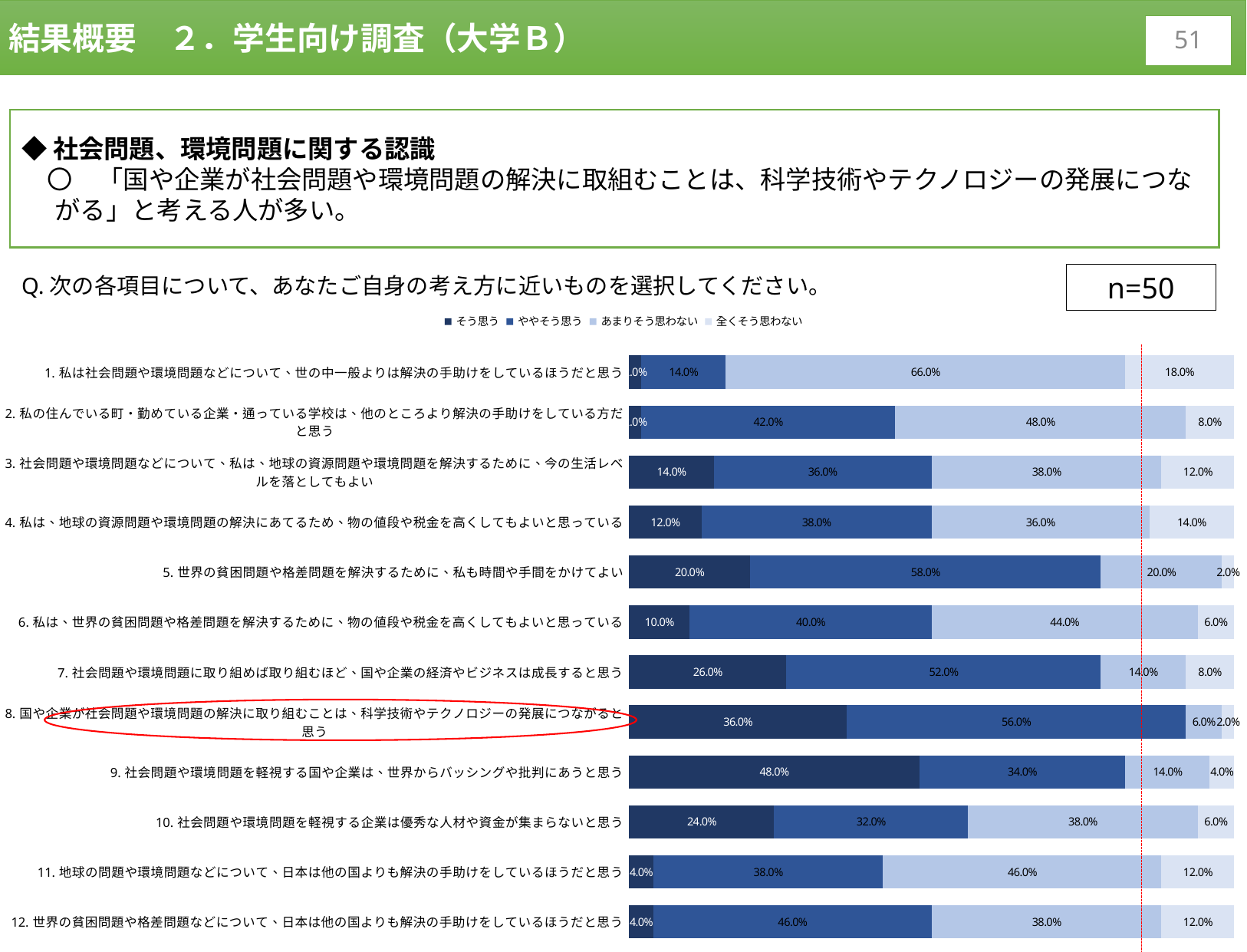
What is the sample size (n) shown on the slide? n=50 What is the combined total of そう思う and ややそう思う for item 8? 92.0% What is the あまりそう思わない value for item 1 (私は社会問題や環境問題などについて、世の中一般よりは解決の手助けをしているほうだと思う)? 66.0% How many series does the legend list? 4 Which item has the lowest 全くそう思わない value? 5 and 8 (both 2.0%) What is the そう思う value for item 8 (国や企業が社会問題や環境問題の解決に取り組むことは、科学技術やテクノロジーの発展につながると思う)? 36.0% What is the difference between the そう思う values for item 9 and item 8? 12.0% How many items (categories) are plotted in the chart? 12 What is the ややそう思う value for item 5 (世界の貧困問題や格差問題を解決するために、私も時間や手間をかけてよい)? 58.0% Which item has the highest そう思う value? 9. 社会問題や環境問題を軽視する国や企業は、世界からバッシングや批判にあうと思う What kind of chart is shown on the slide? Stacked bar chart Which is larger: the ややそう思う value for item 7 or for item 10? Item 7 (52.0%)